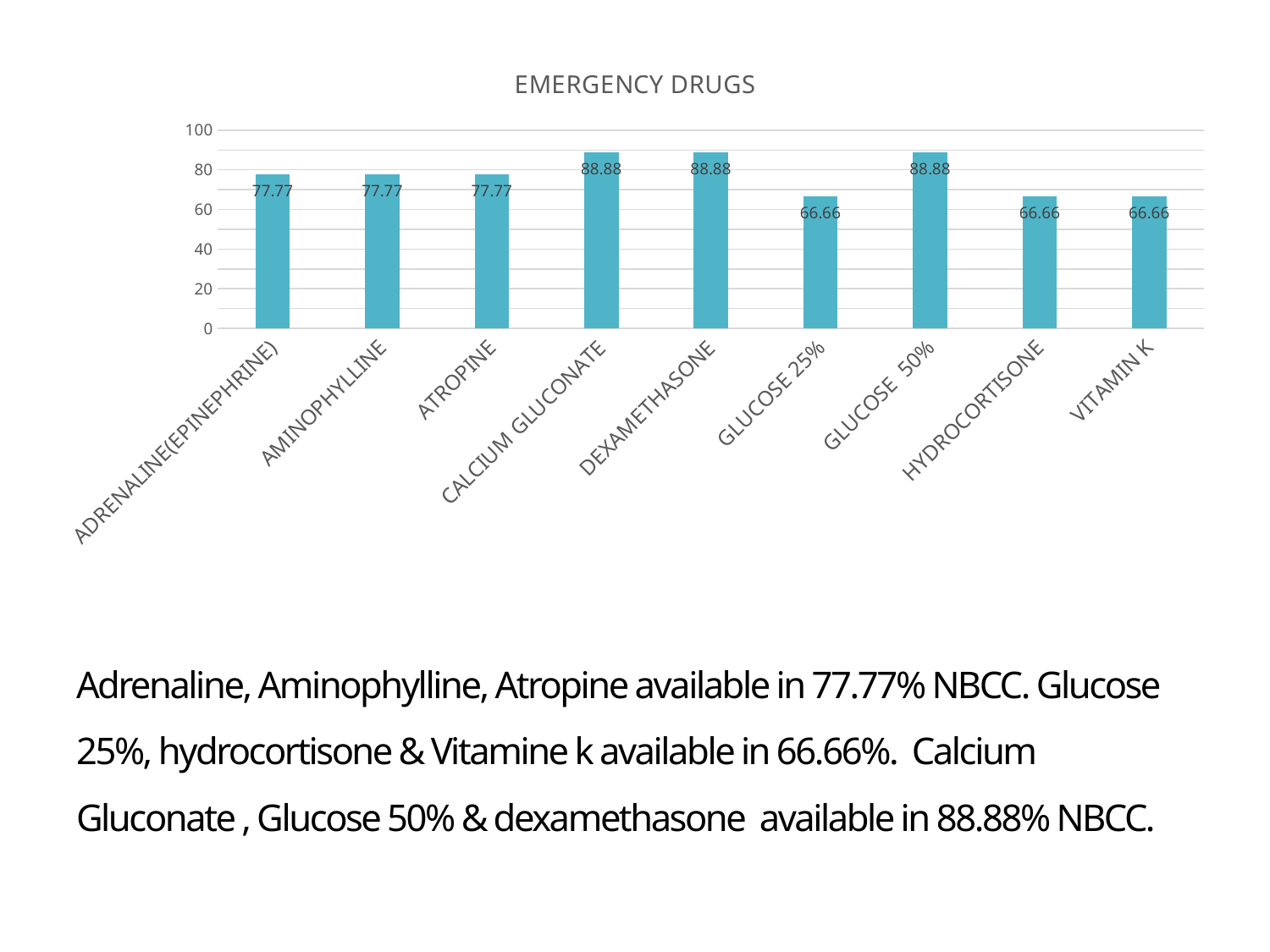
What is the difference between the values for Aminophylline and Vitamin K? 11.11 How many drugs are shown in the chart? 9 What is the lowest value shown in the chart? 66.66 What is the value for Hydrocortisone? 66.66 Which has a larger value, Glucose 50% or Glucose 25%? Glucose 50% What is the value for Atropine in the Emergency Drugs chart? 77.77 What is the difference between the values for Dexamethasone and Glucose 25%? 22.22 What is the highest value shown in the chart? 88.88 Is the value for Vitamin K greater or less than 80? less What is the value for Calcium Gluconate? 88.88 What is the value for Glucose 50%? 88.88 What type of chart is shown on the slide? Bar chart